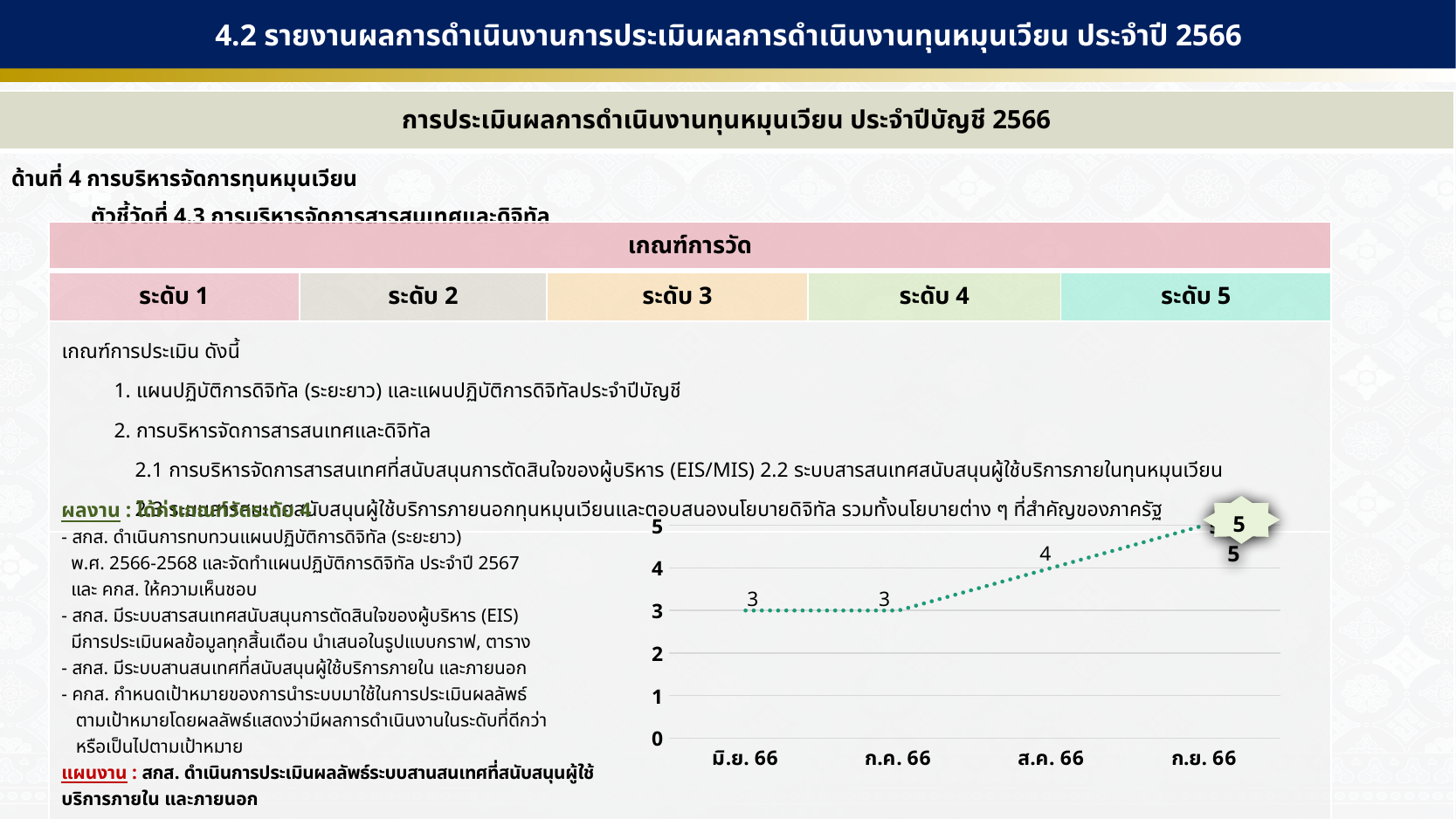
What is the value for ก.ย. 66 in the chart? 5 What is the value for ก.ค. 66 in the chart? 3 Which month has the highest value in the chart? ก.ย. 66 Do the values in the chart rise or fall from มิ.ย. 66 to ก.ย. 66? rise What type of chart is shown on the slide? line chart What is the value for มิ.ย. 66 in the chart? 3 What is the maximum value shown on the vertical axis of the chart? 5 What is the value for ส.ค. 66 in the chart? 4 What is the difference between the values for ส.ค. 66 and ก.ค. 66? 1 How many data points are plotted in the chart? 4 What is the difference between the values for ก.ย. 66 and มิ.ย. 66? 2 Which is larger, the value for ส.ค. 66 or the value for ก.ค. 66? ส.ค. 66